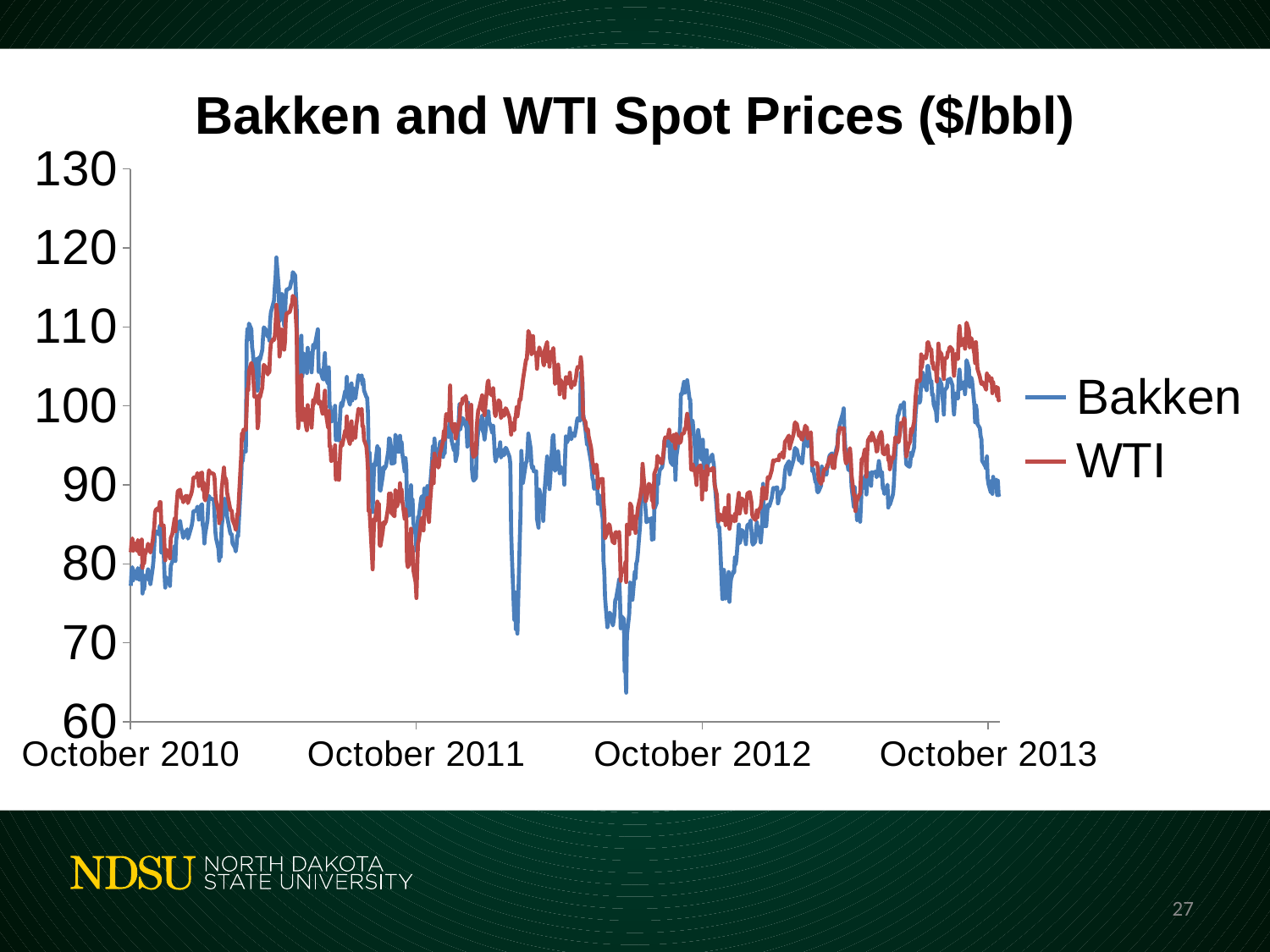
Is the value for Bakken at the end of the series (October 2013) greater or less than 100? less Is the highest value reached by the Bakken series greater or less than 110? greater What is the highest value shown on the vertical axis? 130 How many labelled dates appear on the horizontal axis? 4 Do the prices rise or fall between October 2010 and early 2011? rise How many series does the legend list? 2 Which series reaches the highest peak on the chart, Bakken or WTI? Bakken Is the lowest value reached by the Bakken series greater or less than 70? less What kind of chart is shown on the slide? line chart Which colour is used for the WTI series? red What is the title of the chart? Bakken and WTI Spot Prices ($/bbl) Which series reaches the lowest value on the chart, Bakken or WTI? Bakken